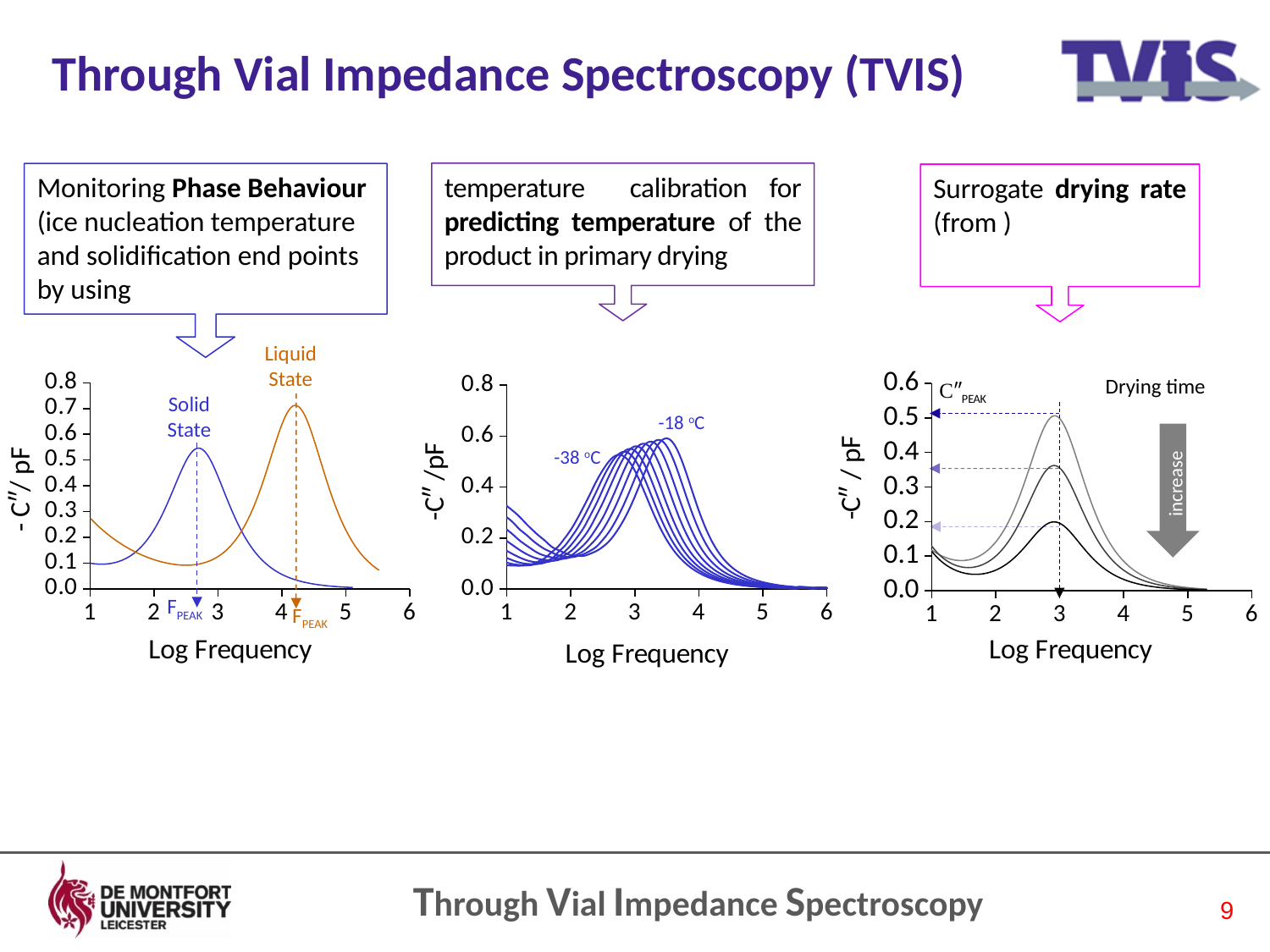
In the right chart, is the peak of the lowest curve greater or less than 0.3? less In the left chart, is the peak value of the Liquid State curve greater or less than 0.6? greater In the middle chart, is the peak of the -18 °C curve greater or less than 0.4? greater In the left chart, which curve peaks at a higher log frequency, Solid State or Liquid State? Liquid State In the right chart, does the peak value rise or fall as drying time increases? fall In the left chart, which state has the higher peak, Solid State or Liquid State? Liquid State How many curves are plotted in the right chart? 3 In the right chart, at what log frequency do the curves peak, as marked by the dashed vertical line? 3 What is the x-axis label of the middle chart? Log Frequency In the middle chart, which temperature curve peaks at a higher log frequency, -38 °C or -18 °C? -18 °C What kind of chart is the left chart showing Solid State and Liquid State? line chart